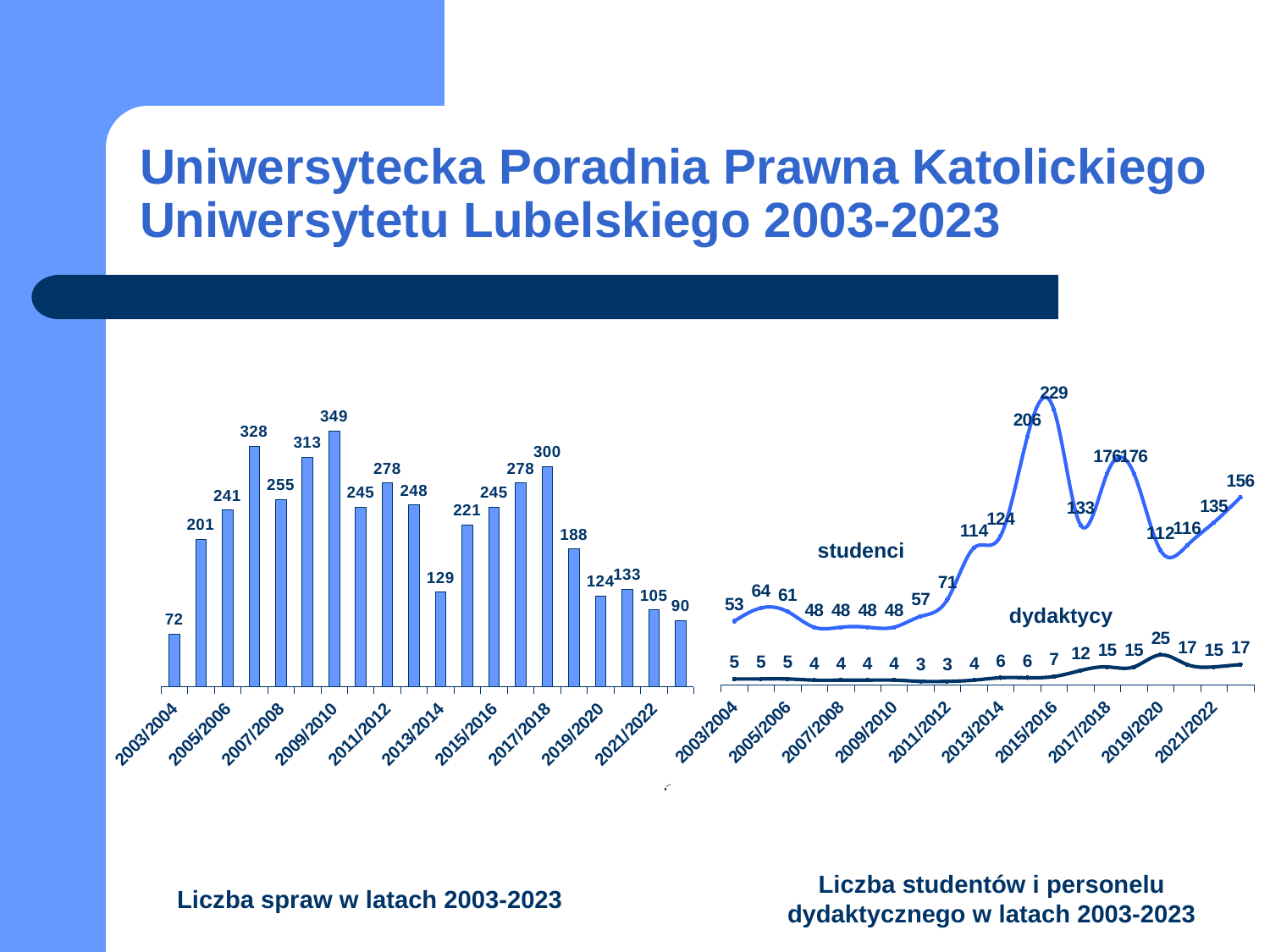
In the right chart 'Liczba studentów i personelu dydaktycznego w latach 2003-2023', what is the value of 'studenci' for 2021/2022? 135 In the left chart 'Liczba spraw w latach 2003-2023', which labeled year has the highest value? 2009/2010 In the left chart 'Liczba spraw w latach 2003-2023', which is larger, the value for 2005/2006 or the value for 2013/2014? 2005/2006 How many bars are plotted in the left chart 'Liczba spraw w latach 2003-2023'? 20 In the left chart 'Liczba spraw w latach 2003-2023', what is the value for 2009/2010? 349 In the right chart 'Liczba studentów i personelu dydaktycznego w latach 2003-2023', what is the value of 'dydaktycy' for 2019/2020? 25 In the right chart 'Liczba studentów i personelu dydaktycznego w latach 2003-2023', what is the highest value of the 'studenci' series? 229 What are the names of the two series in the right chart 'Liczba studentów i personelu dydaktycznego w latach 2003-2023'? studenci and dydaktycy In the left chart 'Liczba spraw w latach 2003-2023', what is the value for 2003/2004? 72 In the left chart 'Liczba spraw w latach 2003-2023', what is the difference between the values for 2017/2018 and 2021/2022? 195 How many series are plotted in the right chart 'Liczba studentów i personelu dydaktycznego w latach 2003-2023'? 2 What kind of chart is the left chart, 'Liczba spraw w latach 2003-2023'? bar chart